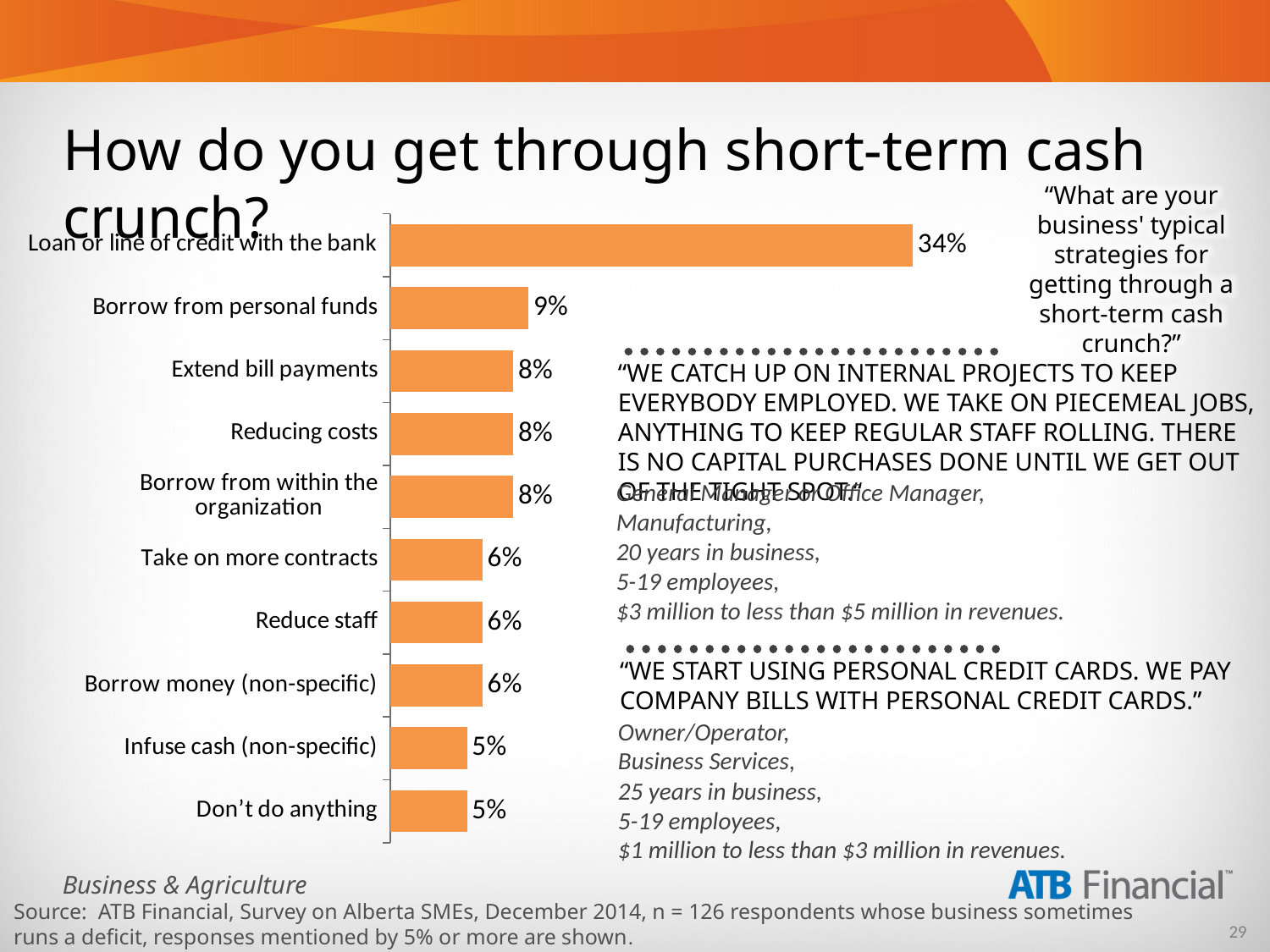
What is the value shown for "Take on more contracts"? 6% What is the difference between "Extend bill payments" and "Infuse cash (non-specific)"? 3 percentage points What is the difference in percentage points between "Loan or line of credit with the bank" and "Borrow from personal funds"? 25 percentage points What colour are the bars in the chart? Orange Which strategy has the highest percentage in the chart? Loan or line of credit with the bank What type of chart is used on this slide? Bar chart What is the value shown for "Don't do anything"? 5% How many strategies (categories) are shown in the chart? 10 What is the value shown for "Borrow from personal funds"? 9% What percentage of respondents use a loan or line of credit with the bank to get through a short-term cash crunch? 34% What is the value shown for "Borrow from within the organization"? 8% Which is larger: the value for "Reducing costs" or the value for "Reduce staff"? Reducing costs